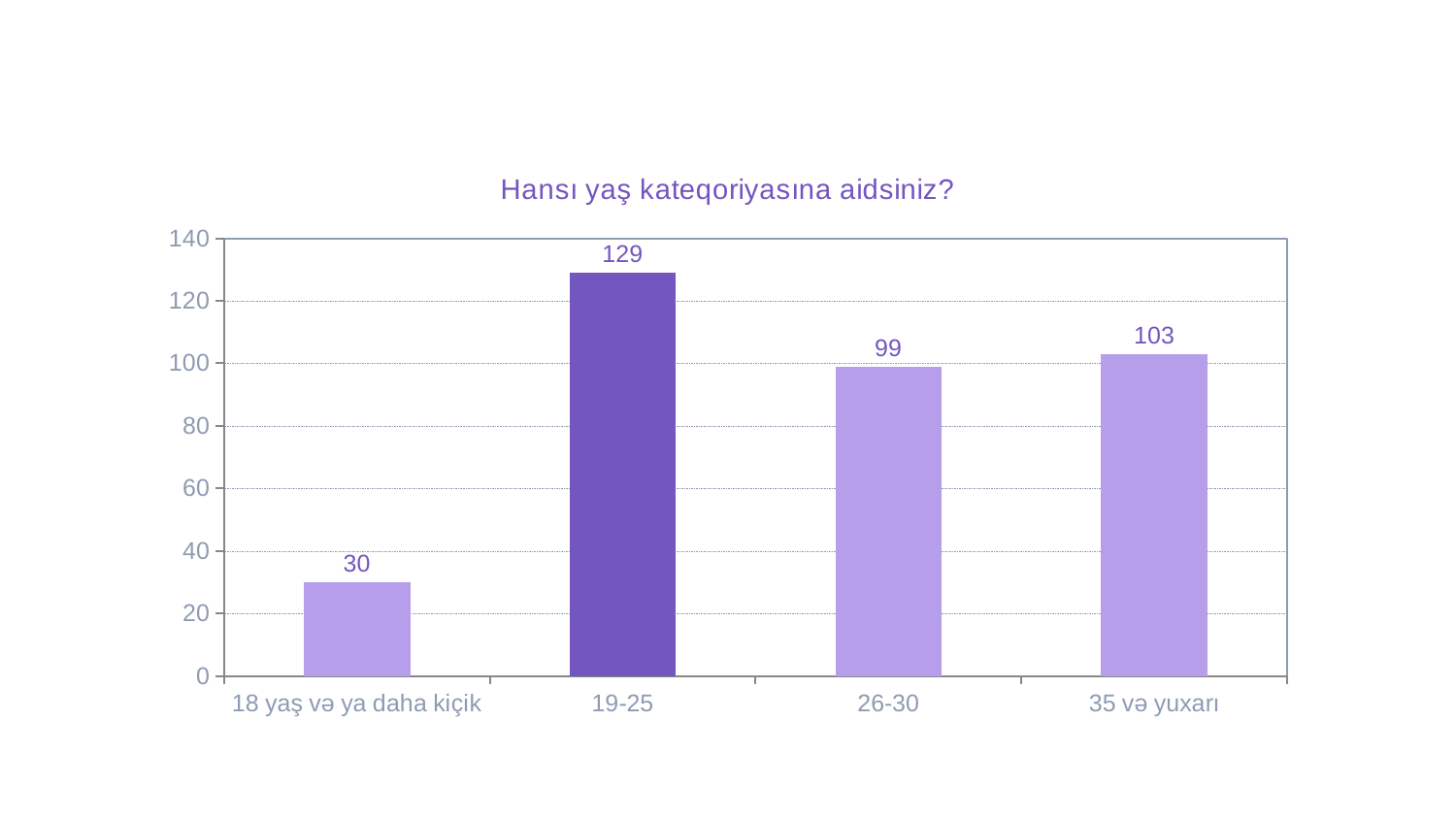
Is the value for 35 və yuxarı greater or less than 100? greater What is the value for the 19-25 category? 129 How many categories are shown on the chart? 4 What kind of chart is shown on the slide? bar chart What is the title of the chart? Hansı yaş kateqoriyasına aidsiniz? What is the difference between the values for 19-25 and 26-30? 30 What is the value for the 18 yaş və ya daha kiçik category? 30 What is the value for the 35 və yuxarı category? 103 Which category has the highest value? 19-25 What is the value for the 26-30 category? 99 Which is larger, the value for 26-30 or the value for 35 və yuxarı? 35 və yuxarı Which category has the lowest value? 18 yaş və ya daha kiçik